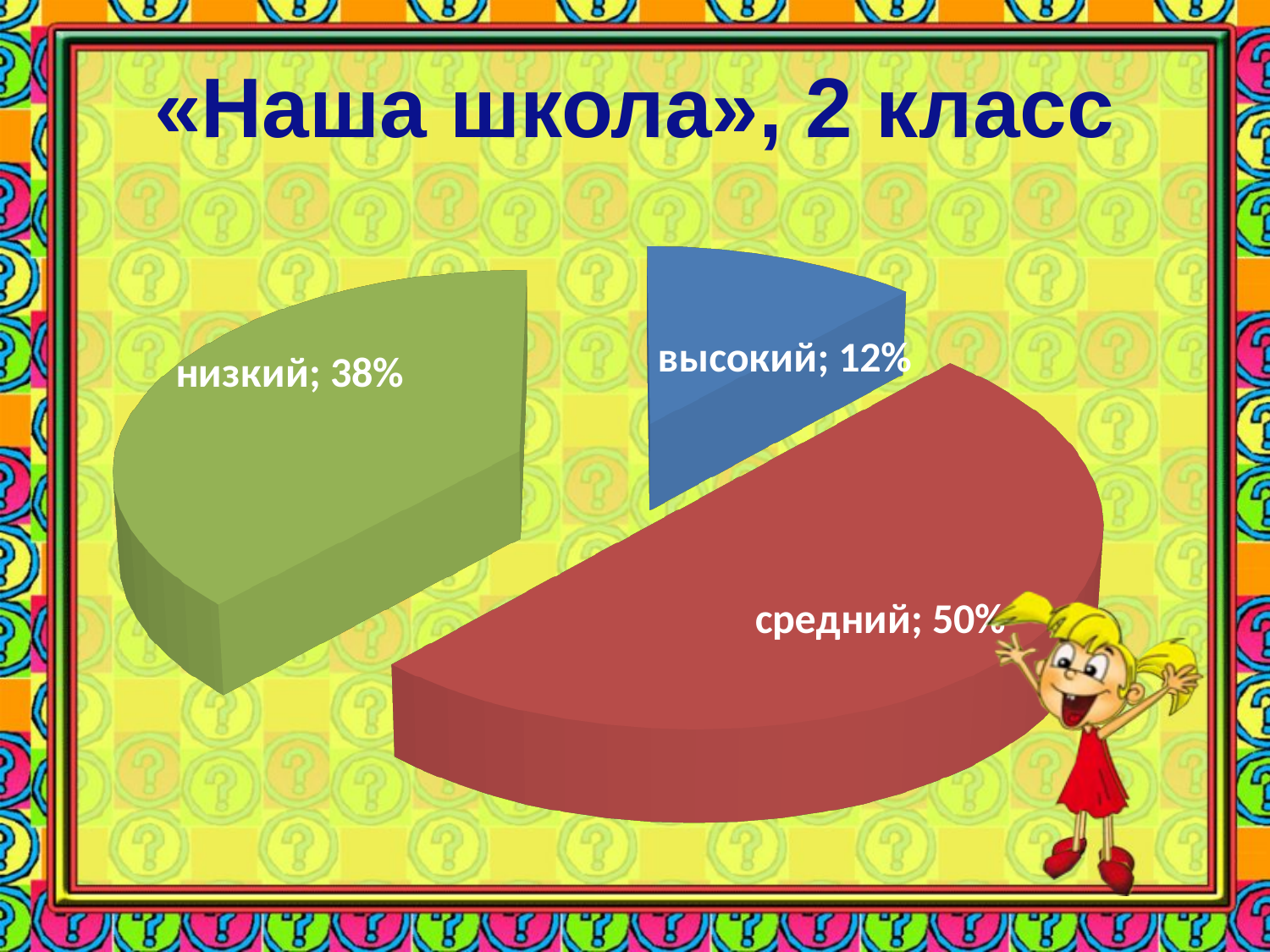
What is the value for низкий? 38% What colour is the slice for средний? red Which category has the smallest share? высокий What is the value for средний? 50% What is the difference between the shares for средний and низкий? 12% What is the title of the slide with the chart? «Наша школа», 2 класс What is the difference between the shares for низкий and высокий? 26% Which is larger, the share for низкий or the share for высокий? низкий Which category has the largest share? средний What kind of chart is shown on the slide? pie chart What is the value for высокий? 12% How many slices does the pie chart have? 3